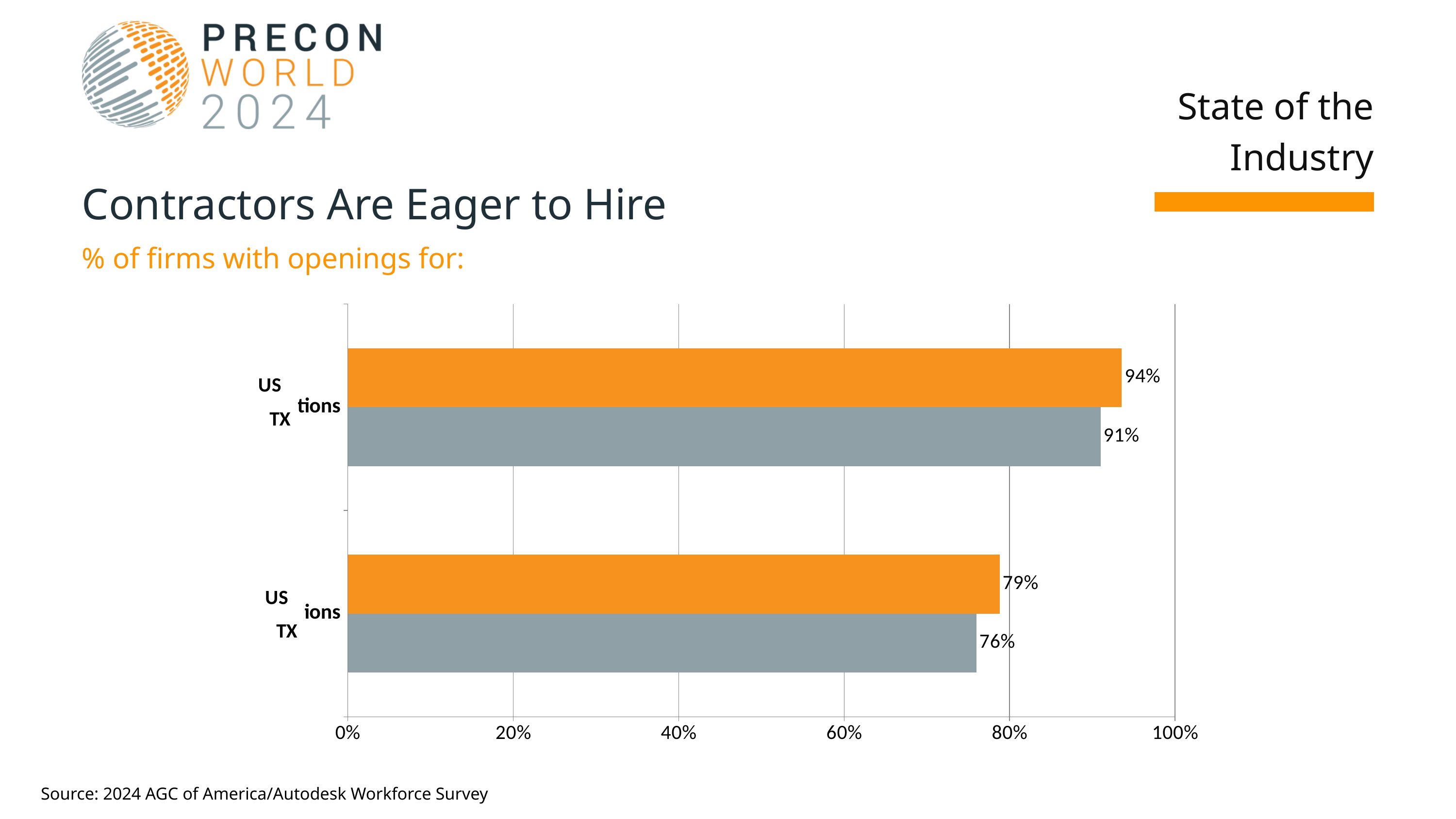
In the bottom group of bars, what is the value for US? 79% Which bar has the lowest value on the chart? TX in the bottom group (76%) How much higher is the US value in the top group than the US value in the bottom group? 15 percentage points What kind of chart is shown on the slide? Bar chart In the top group of bars, what is the value for US? 94% In the bottom group, which is larger, the US value or the TX value? US What colour are the US bars? Orange In the top group, how much higher is the US value than the TX value? 3 percentage points In the bottom group of bars, what is the value for TX? 76% How many bars are plotted on the chart? 4 Which bar has the highest value on the chart? US in the top group (94%) In the top group of bars, what is the value for TX? 91%